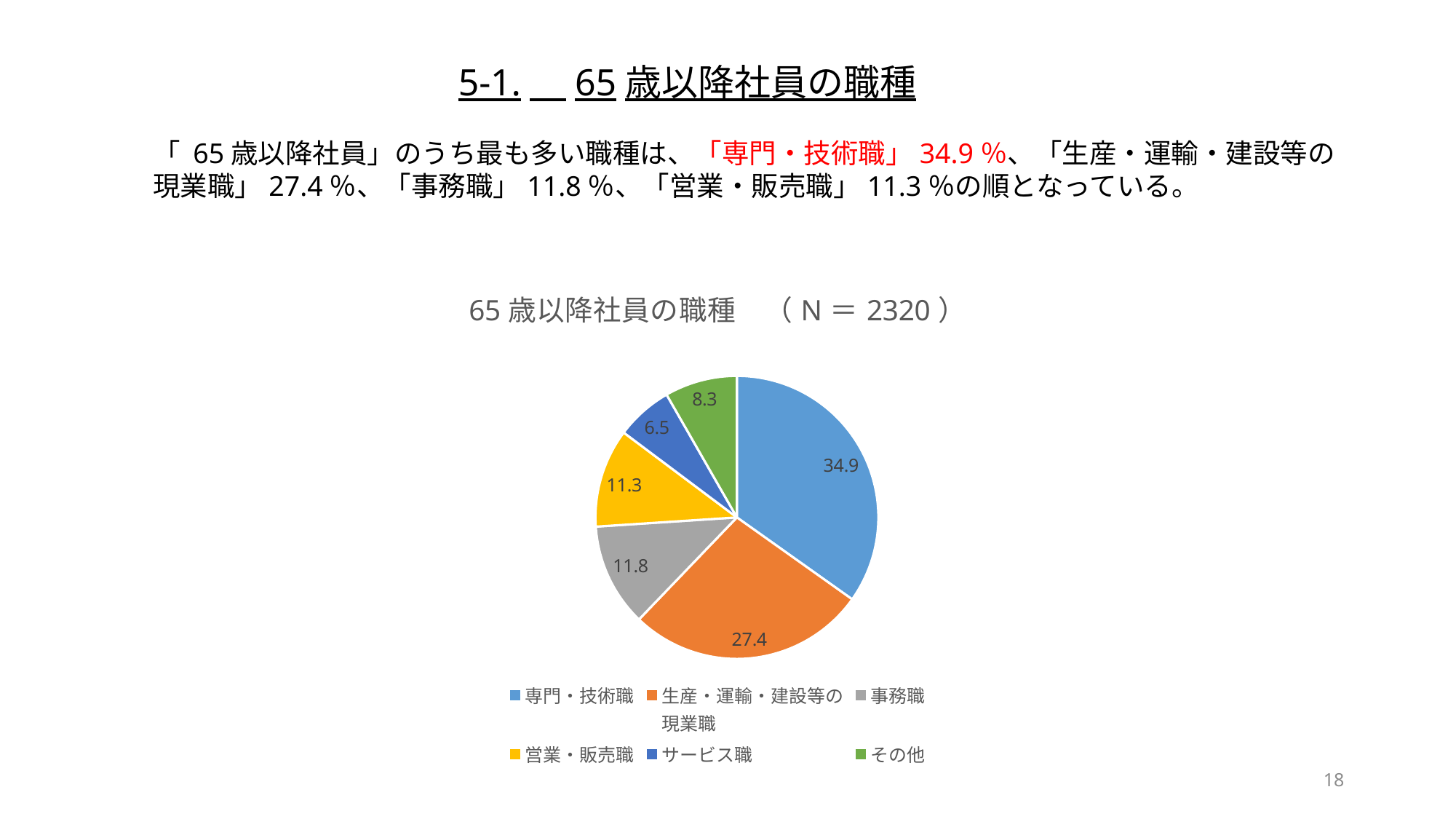
Which category has the smallest slice in the pie chart? サービス職 What is the value for 事務職 in the pie chart? 11.8 Which is larger, the value for 営業・販売職 or the value for その他? 営業・販売職 What is the value for その他 in the pie chart? 8.3 What is the value for 専門・技術職 in the pie chart? 34.9 What is the N value shown in the chart title? 2320 What is the value for 生産・運輸・建設等の現業職 in the pie chart? 27.4 What is the value for サービス職 in the pie chart? 6.5 How many categories does the pie chart show? 6 What kind of chart is shown on the slide? pie chart What is the difference between the values for 専門・技術職 and 生産・運輸・建設等の現業職? 7.5 Which category has the largest slice in the pie chart? 専門・技術職